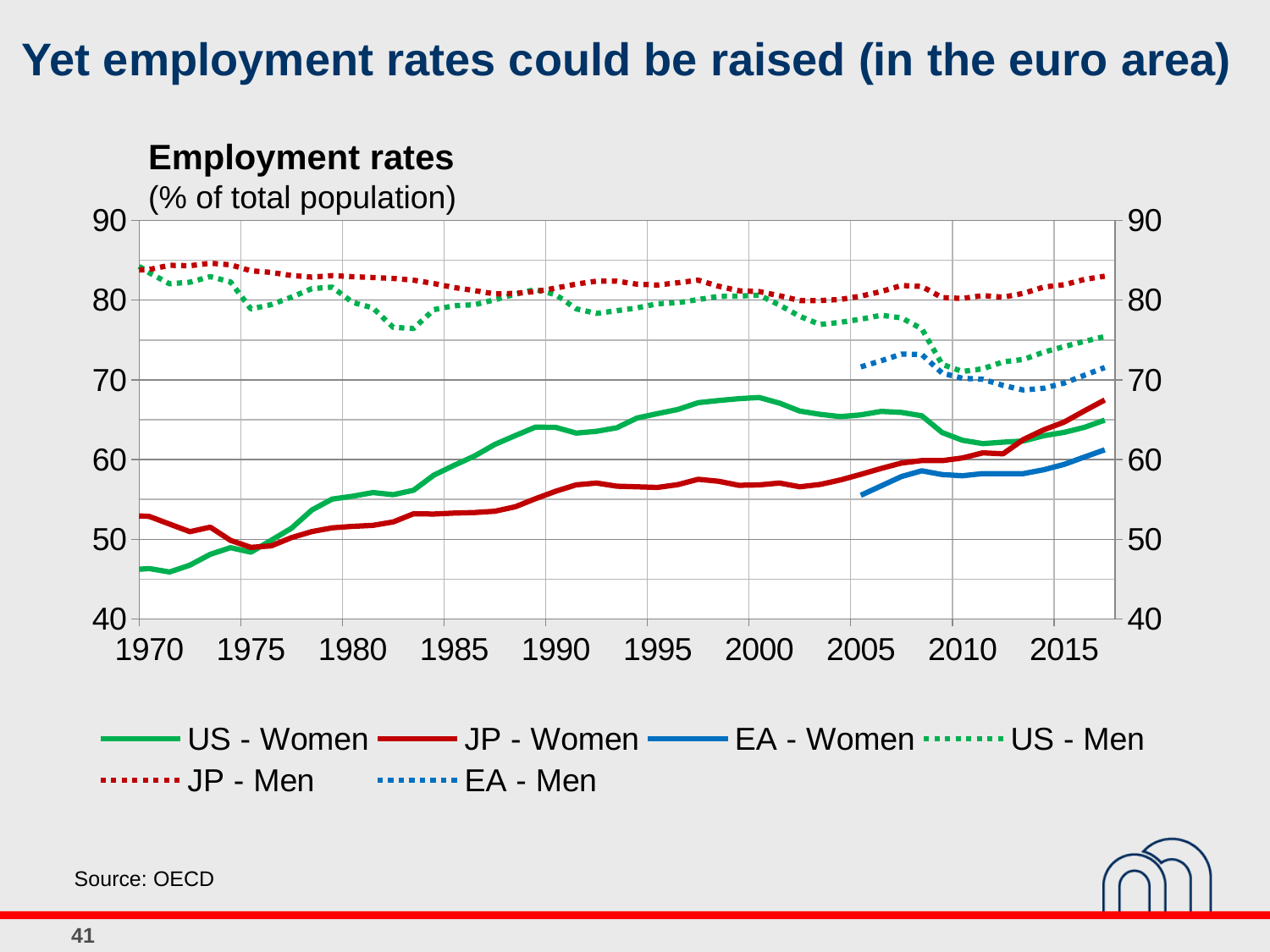
In 2005, which is larger: US - Women or EA - Women? US - Women Which series has the lowest value at the right end of the chart (2017)? EA - Women Is the value for US - Women in 1970 greater or less than 50? less Is the value for EA - Women in 2005 greater or less than 60? less Does the US - Women line rise or fall between 1970 and 2000? rise What kind of chart is shown on the slide? line chart Is the value for JP - Women in 1970 greater or less than 50? greater Which series has the lowest value in 1970? US - Women What is the source cited for the chart? OECD How many series does the legend list? 6